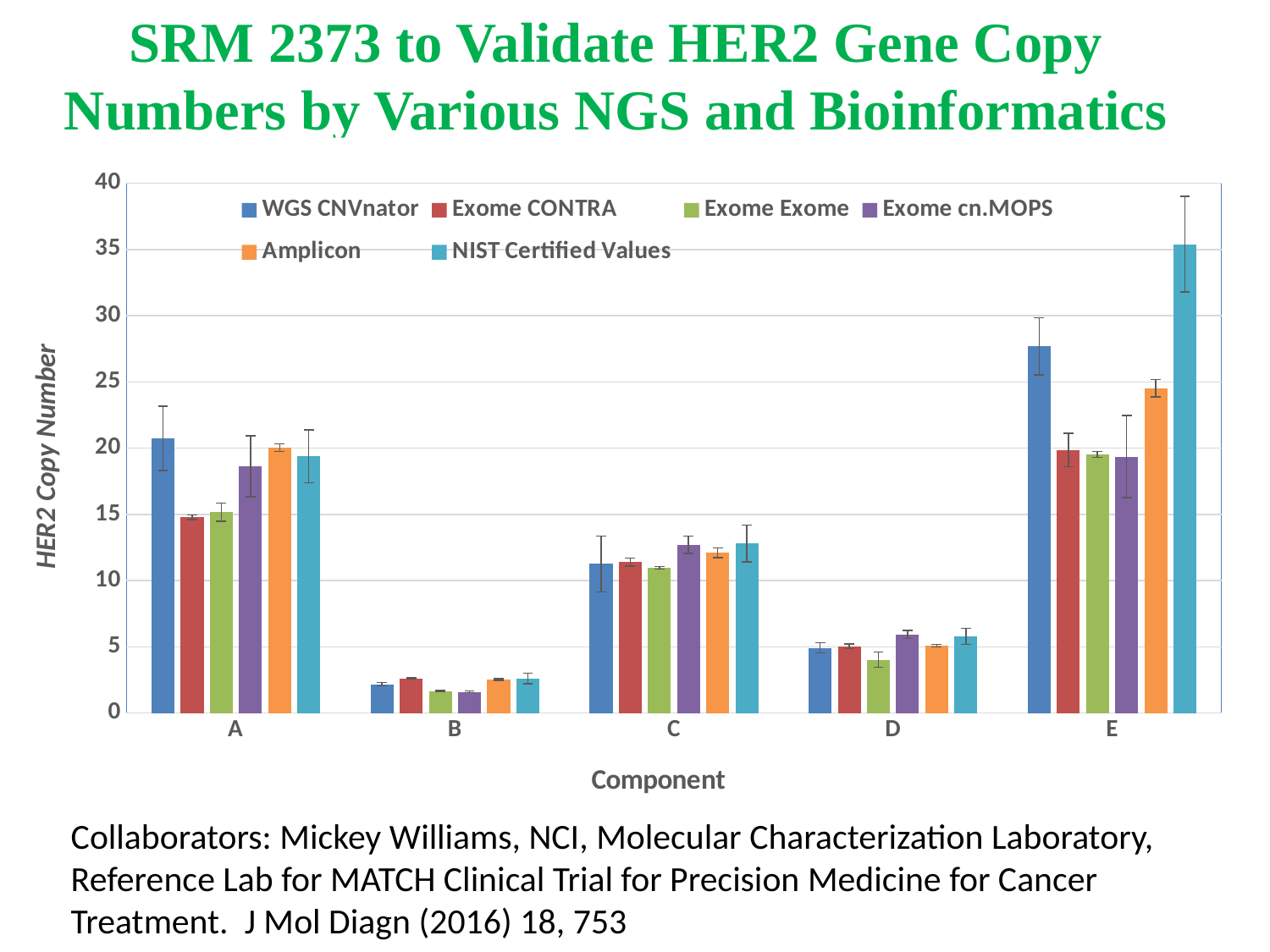
What is the title of the y axis? HER2 Copy Number What kind of chart is shown on the slide? bar chart Is the Exome Exome bar for component D greater or less than 5? less For component A, which is larger: WGS CNVnator or Exome CONTRA? WGS CNVnator Which component has the highest NIST Certified Values bar? E For component E, which series has the highest bar? NIST Certified Values Which component has the lowest WGS CNVnator bar? B Is the NIST Certified Values bar for component E greater or less than 30? greater Is the Amplicon bar for component E greater or less than 20? greater For component E, which is larger: WGS CNVnator or Amplicon? WGS CNVnator How many series does the legend list? 6 How many components are shown on the x axis? 5